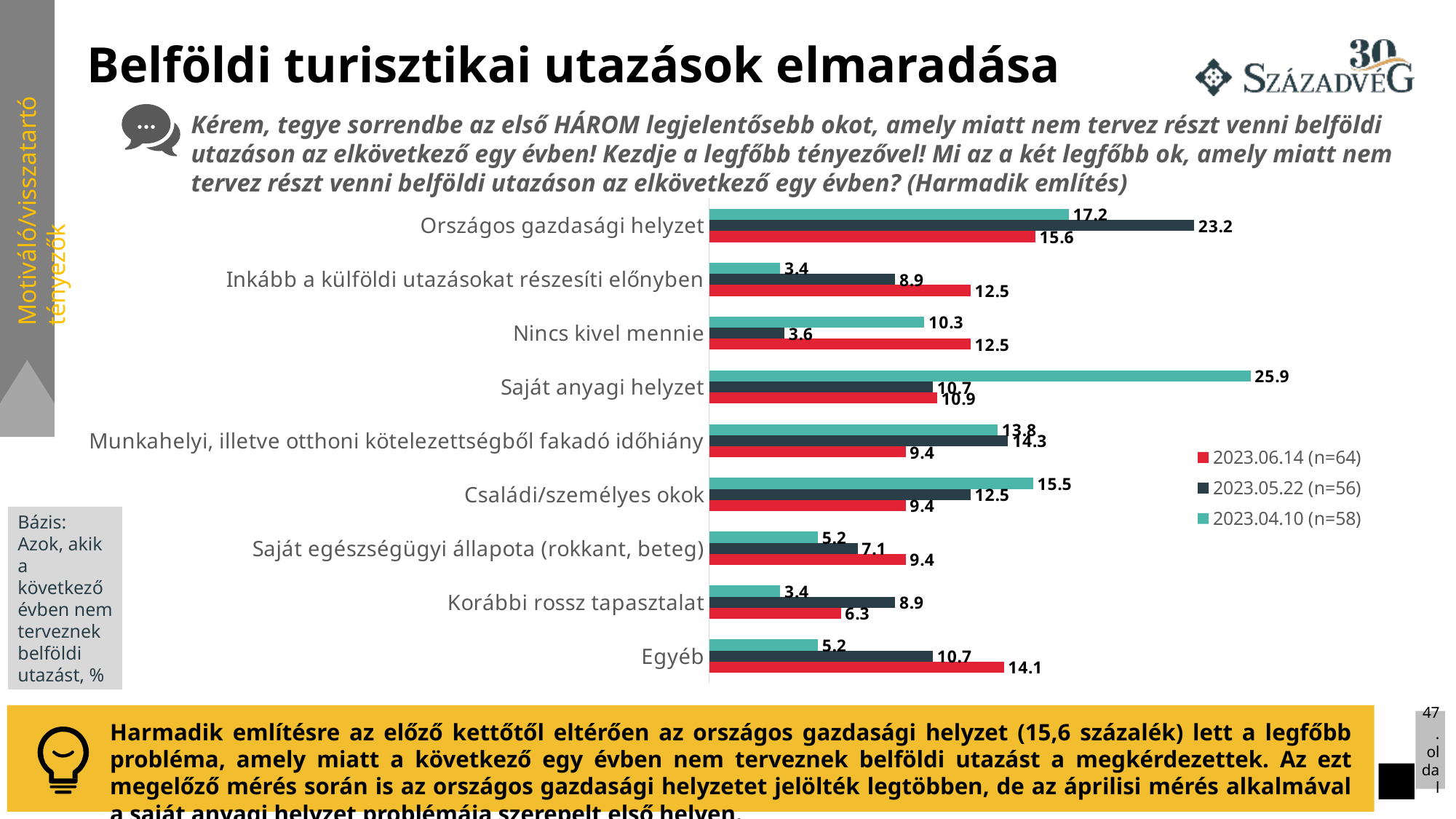
What is the difference between the 2023.05.22 (n=56) and 2023.06.14 (n=64) values for 'Országos gazdasági helyzet'? 7.6 What is the value for 'Korábbi rossz tapasztalat' in the 2023.05.22 (n=56) series? 8.9 How many series does the legend list? 3 What is the value for 'Saját anyagi helyzet' in the 2023.04.10 (n=58) series? 25.9 How many categories are shown on the chart? 9 Which category has the lowest value in the 2023.05.22 (n=56) series? Nincs kivel mennie What is the value for 'Országos gazdasági helyzet' in the 2023.06.14 (n=64) series? 15.6 For 'Nincs kivel mennie', which series has the larger value: 2023.04.10 (n=58) or 2023.05.22 (n=56)? 2023.04.10 (n=58) What type of chart is shown on the slide? bar chart Which category has the highest value in the 2023.05.22 (n=56) series? Országos gazdasági helyzet Which category has the lowest value in the 2023.06.14 (n=64) series? Korábbi rossz tapasztalat Which colour represents the 2023.06.14 (n=64) series? red